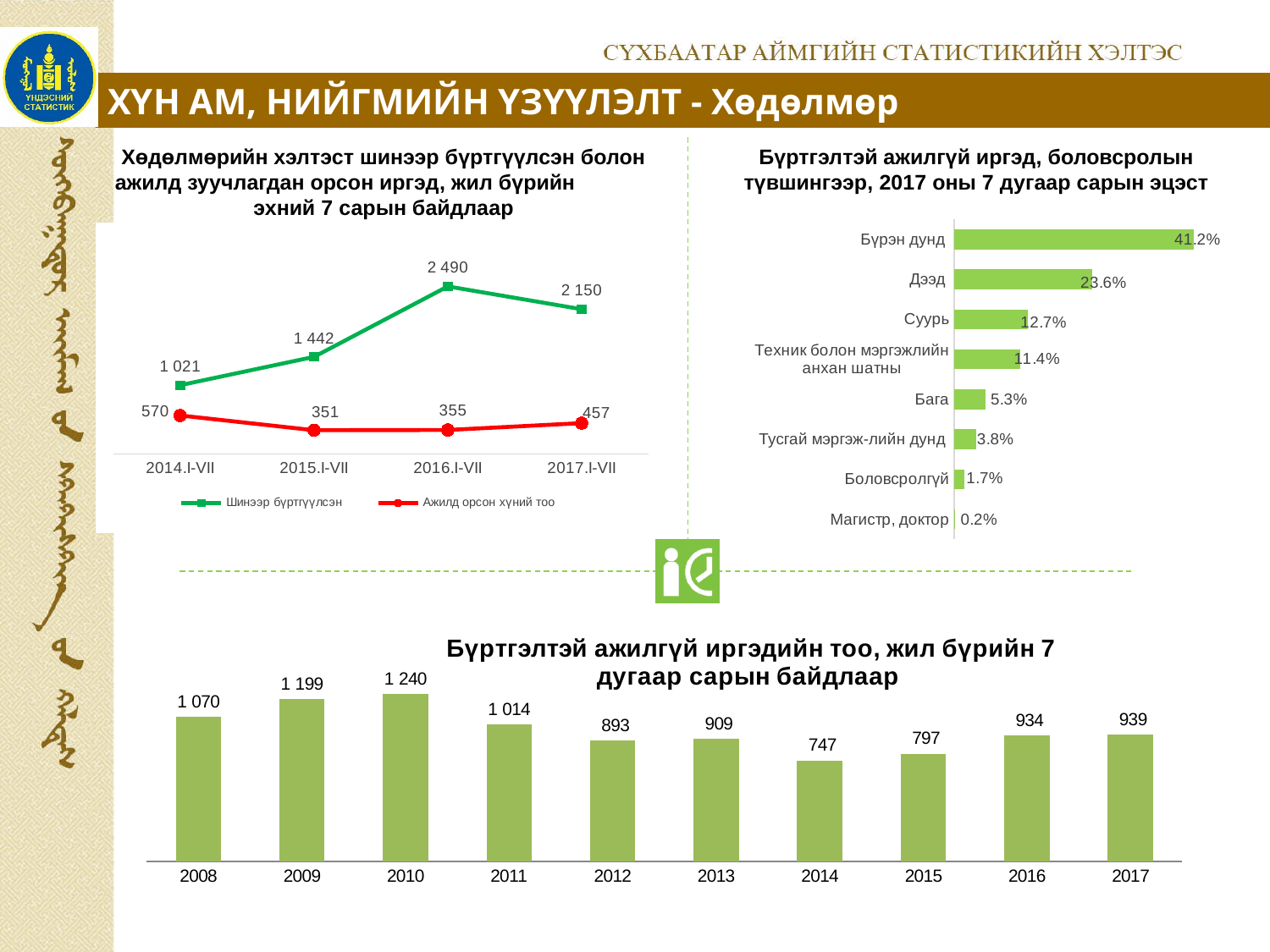
In the top-right bar chart on education level, what is the value for Дээд? 23.6% In the top-right bar chart on education level, how many categories are shown? 8 In the top-left line chart, what is the value of Шинээр бүртгүүлсэн for 2016.I-VII? 2 490 In the bottom bar chart of registered unemployed by year, which year has the highest value? 2010 In the top-left line chart, how many series does the legend list? 2 In the top-left line chart, what is the difference between Шинээр бүртгүүлсэн and Ажилд орсон хүний тоо for 2017.I-VII? 1 693 In the top-right bar chart on education level, which category has the highest share? Бүрэн дунд What type of chart is the bottom chart on the slide? Bar chart In the top-right bar chart on education level, which category has the lowest share? Магистр, доктор In the bottom bar chart of registered unemployed by year, which is larger: the value for 2012 or the value for 2013? 2013 In the bottom bar chart of registered unemployed by year, what is the value for 2014? 747 In the top-left line chart, what is the value of Ажилд орсон хүний тоо for 2014.I-VII? 570